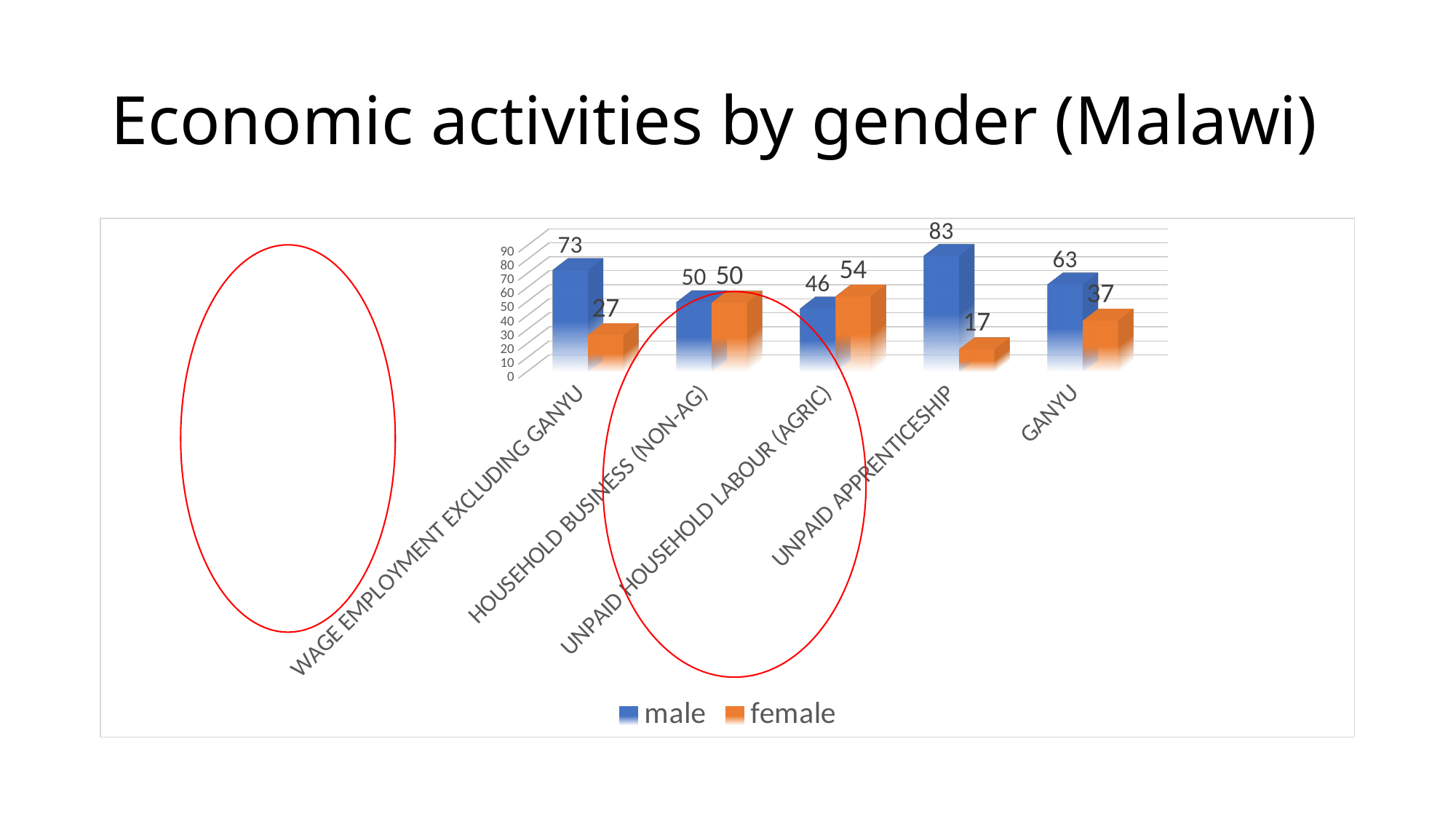
Which category has the highest male value? Unpaid Apprenticeship What is the male value for Ganyu? 63 How many categories are shown on the x axis? 5 What is the male value for Unpaid Apprenticeship? 83 What are the two series named in the legend? male and female What is the female value for Wage Employment Excluding Ganyu? 27 Which is larger for Unpaid Household Labour (Agric), the male value or the female value? female What is the difference between the male and female values for Wage Employment Excluding Ganyu? 46 What is the female value for Unpaid Household Labour (Agric)? 54 How many series does the legend list? 2 What kind of chart is shown on the slide? bar chart Which category has the lowest female value? Unpaid Apprenticeship